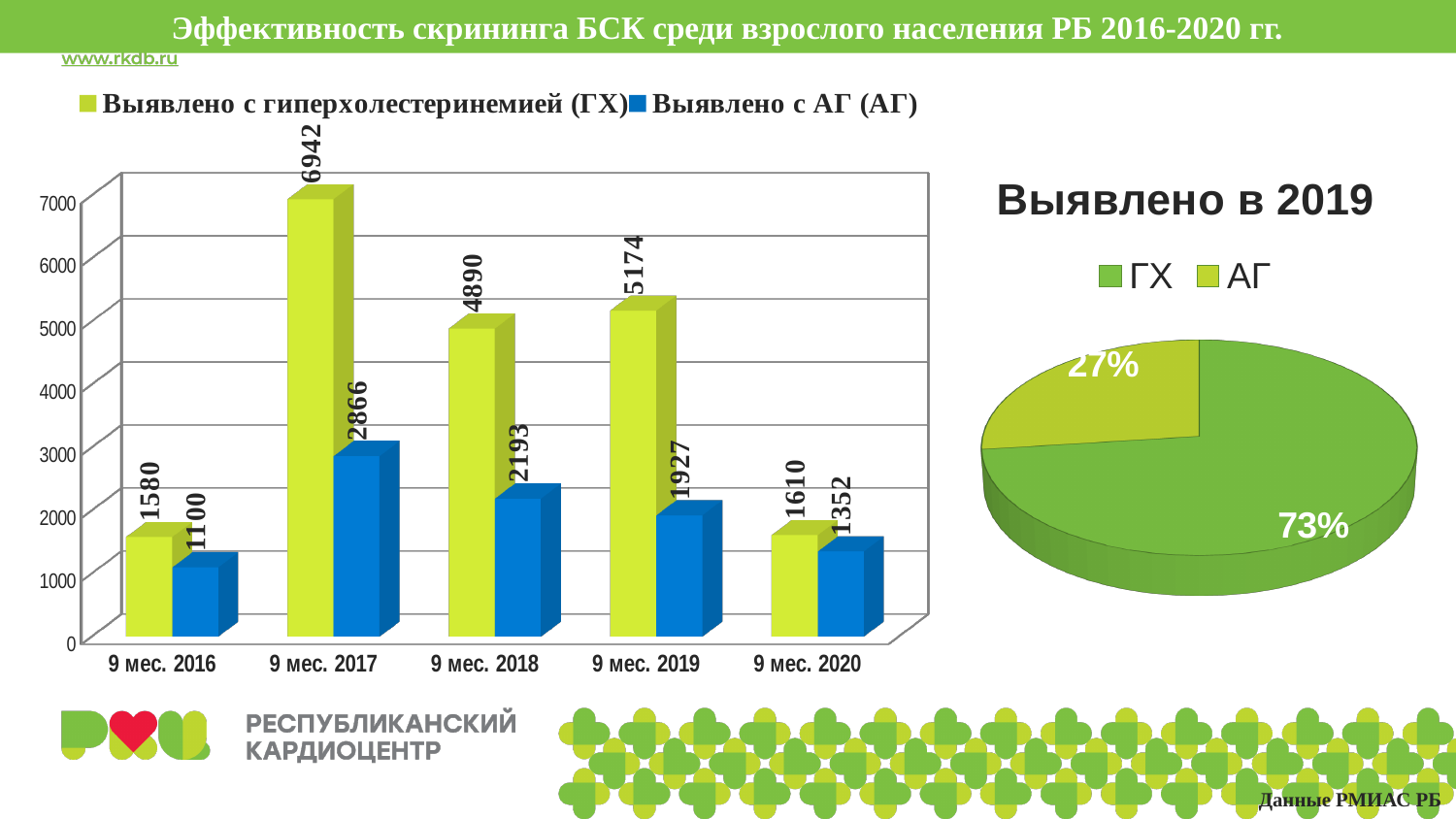
On the pie chart 'Выявлено в 2019', what share does 'ГХ' have? 73% What kind of chart is the chart on the left of the slide? bar chart On the pie chart 'Выявлено в 2019', what share does 'АГ' have? 27% How many series does the legend of the bar chart list? 2 On the bar chart, which is larger: the ГХ value in '9 мес. 2019' or the ГХ value in '9 мес. 2018'? 9 мес. 2019 On the bar chart, what is the value for 'Выявлено с АГ (АГ)' in '9 мес. 2016'? 1100 On the bar chart, what is the value for 'Выявлено с АГ (АГ)' in '9 мес. 2019'? 1927 On the bar chart, what is the difference between the ГХ and АГ values in '9 мес. 2018'? 2697 On the bar chart, which category has the highest value for 'Выявлено с гиперхолестеринемией (ГХ)'? 9 мес. 2017 How many categories are shown on the x axis of the bar chart? 5 On the bar chart, which category has the lowest value for 'Выявлено с АГ (АГ)'? 9 мес. 2016 On the bar chart, what is the value for 'Выявлено с гиперхолестеринемией (ГХ)' in '9 мес. 2017'? 6942